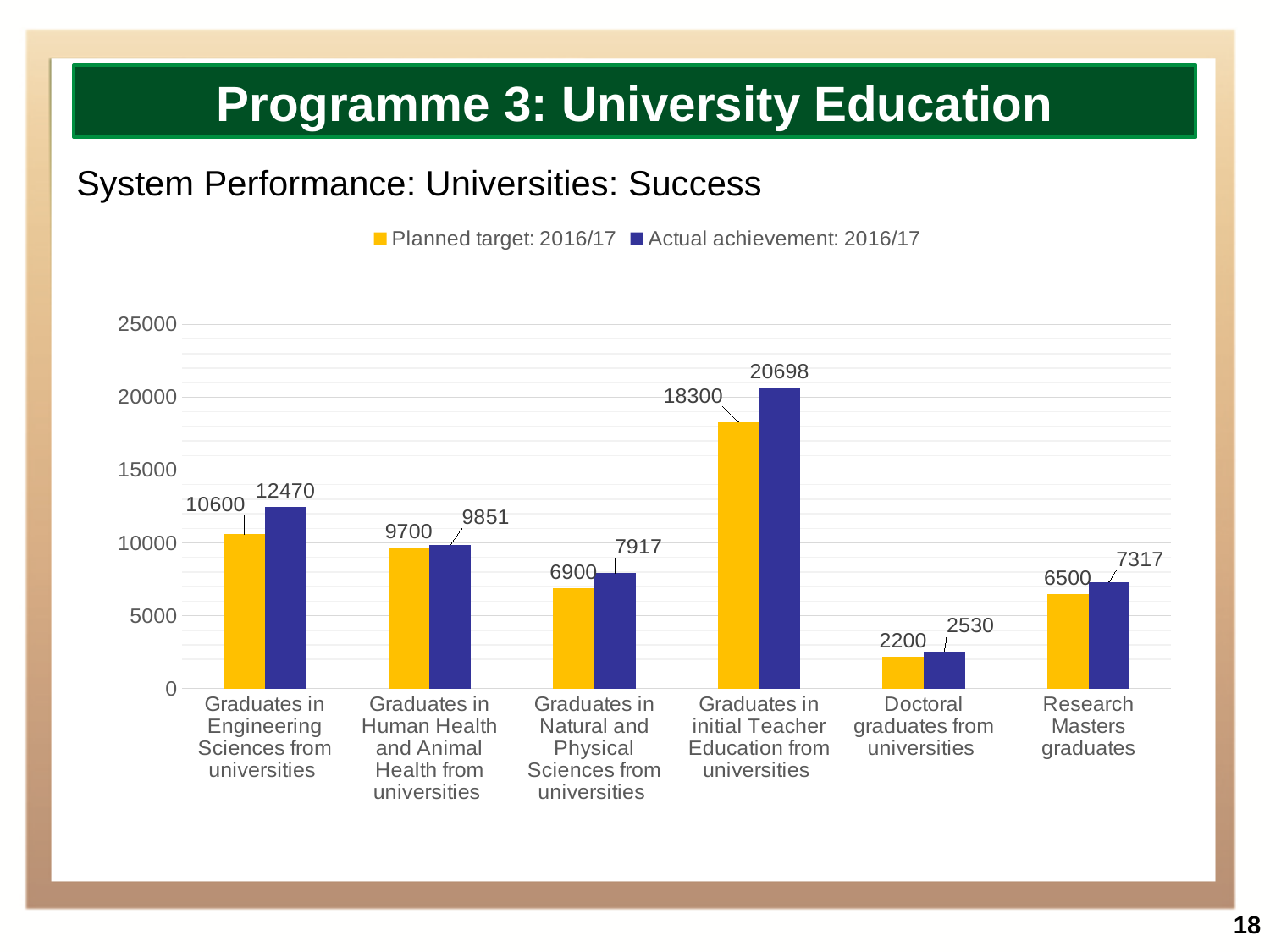
What is the actual achievement for 2016/17 for Doctoral graduates from universities? 2530 How many categories are shown on the x axis? 6 How many series does the legend list? 2 What is the actual achievement for 2016/17 for Graduates in initial Teacher Education from universities? 20698 What colour represents the Planned target: 2016/17 series? Yellow What is the planned target for 2016/17 for Graduates in Engineering Sciences from universities? 10600 Which is larger for Research Masters graduates: the planned target or the actual achievement for 2016/17? Actual achievement: 2016/17 Which category has the highest actual achievement for 2016/17? Graduates in initial Teacher Education from universities What kind of chart is shown on the slide? Bar chart Is the planned target for Graduates in initial Teacher Education from universities greater or less than 15000? greater What is the difference between the actual achievement and the planned target for Graduates in Engineering Sciences from universities? 1870 Which category has the lowest planned target for 2016/17? Doctoral graduates from universities